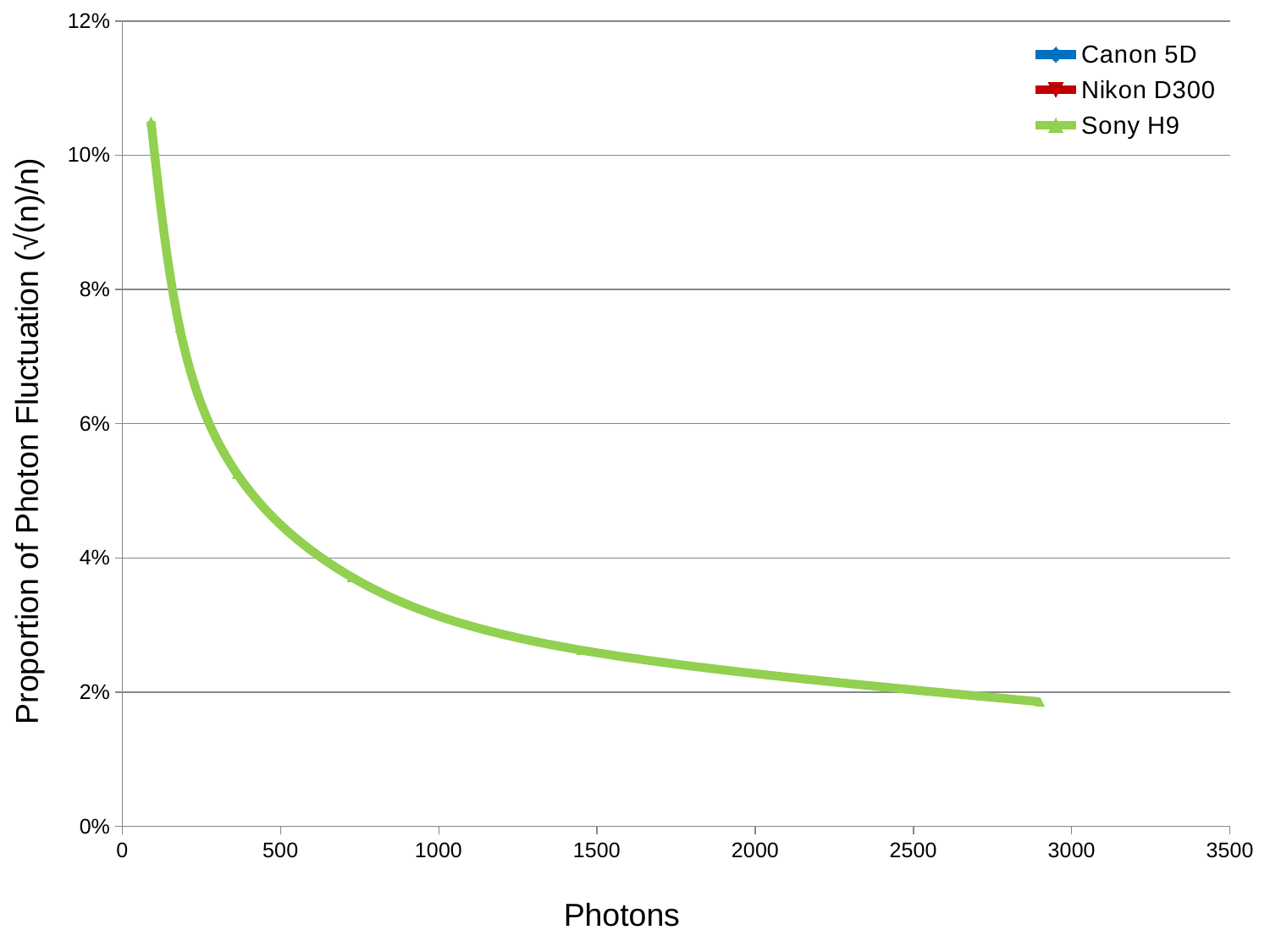
Is the value of the visible curve at 1500 photons greater or less than 4%? less Is the value of the visible curve at 2000 photons greater or less than 2%? greater What is the title of the x axis? Photons Which series are listed in the legend? Canon 5D, Nikon D300, Sony H9 What kind of chart is shown on the slide? line chart Do the plotted values rise or fall as the number of photons increases? fall Is the value of the visible curve at 200 photons greater or less than 6%? greater How many series does the legend list? 3